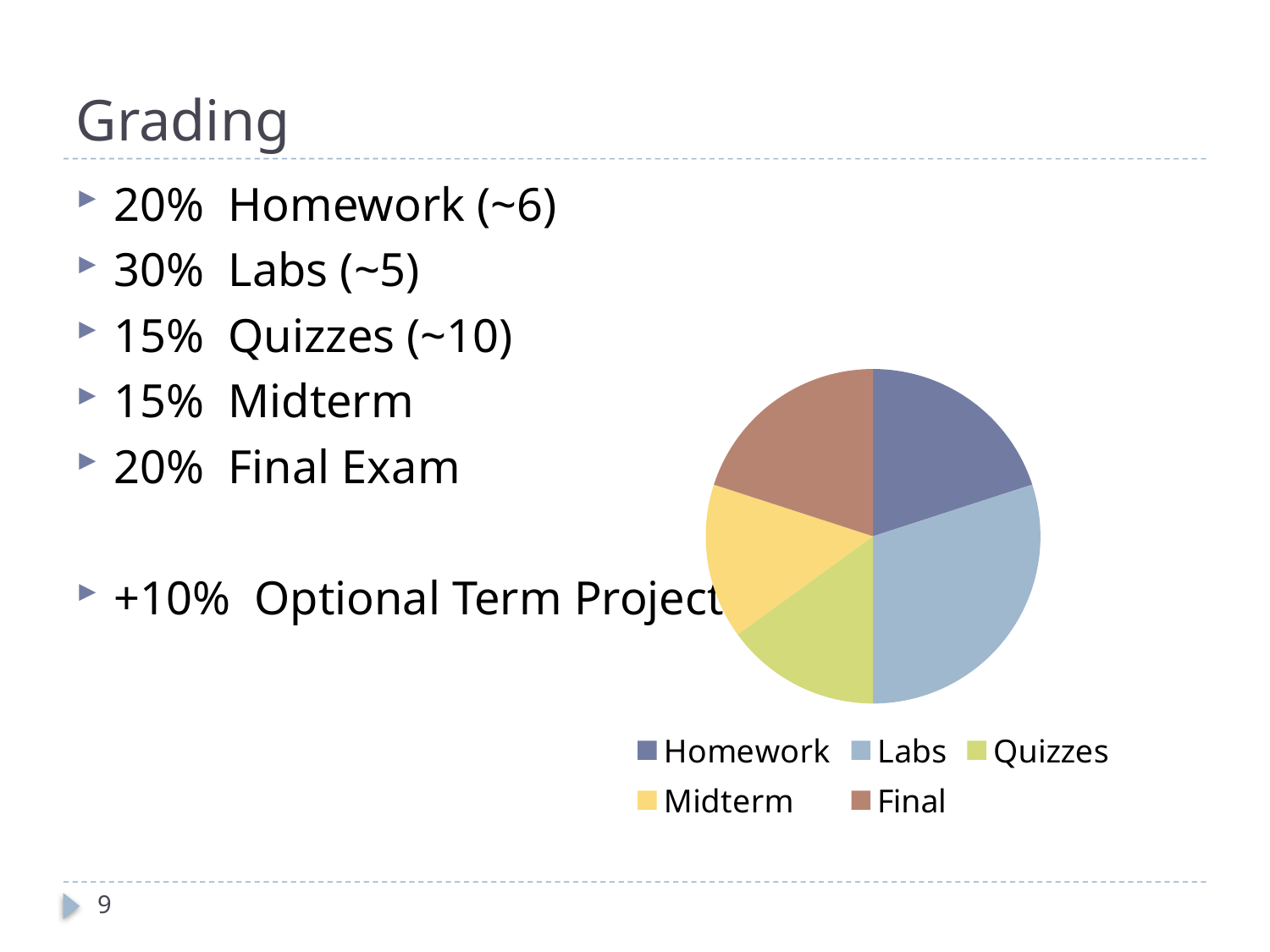
What share of the grade does the Midterm slice represent? 15% How many slices does the pie chart have? 5 Which category has the largest slice in the pie chart? Labs Which category is shown in light blue in the pie chart? Labs How many entries does the legend of the pie chart list? 5 Which slice is larger in the pie chart, Homework or Midterm? Homework What kind of chart is shown on the slide? pie chart Which slice is larger in the pie chart, Final or Quizzes? Final Which category is shown in brown in the pie chart? Final Which slice is larger in the pie chart, Labs or Homework? Labs What share of the grade does the Homework slice represent? 20% What share of the grade does the Labs slice represent? 30%